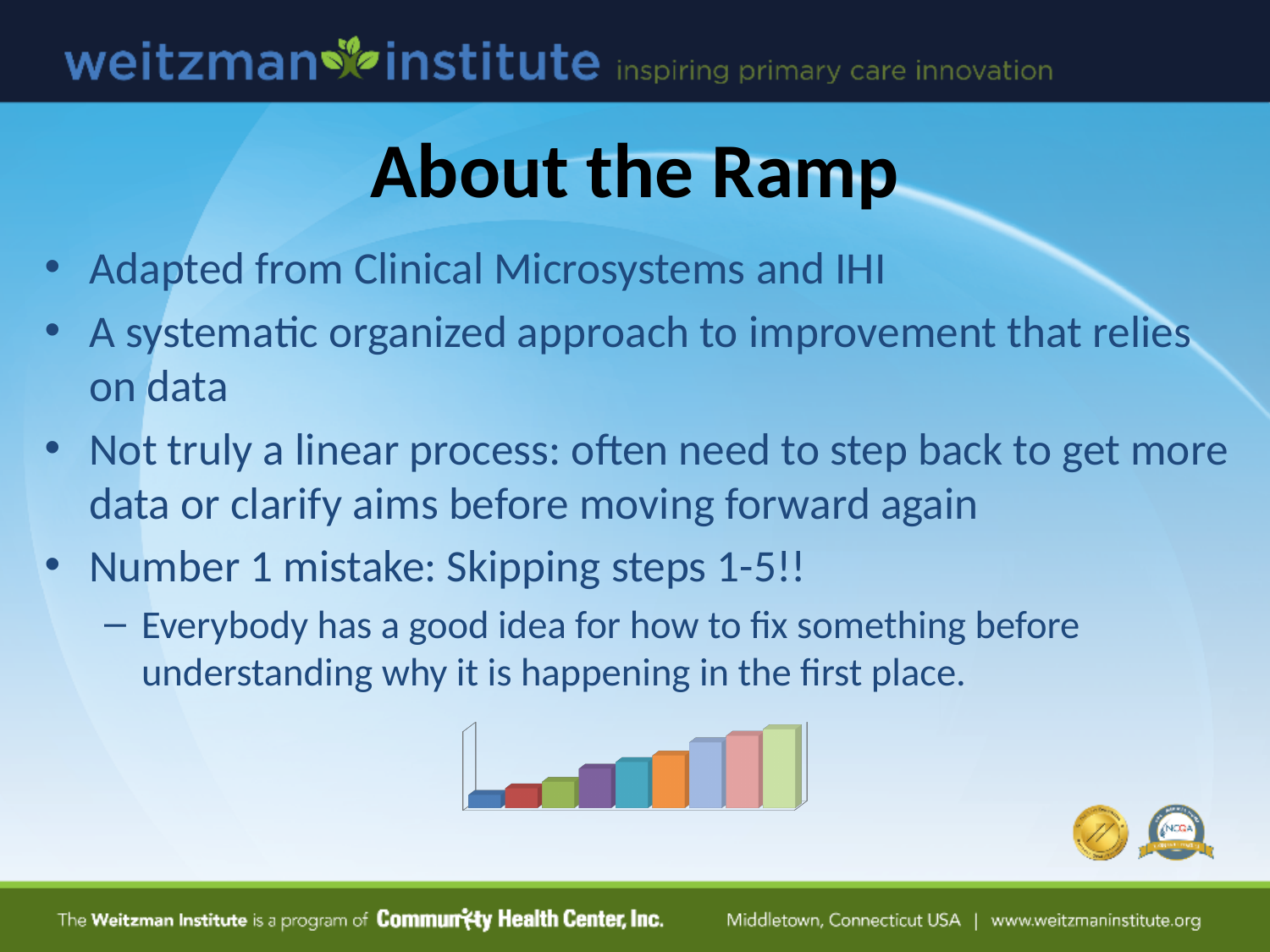
Do the bar heights in the chart rise or fall from left to right? rise What kind of chart is shown at the bottom of the slide? bar chart What colour is the tallest bar in the chart? light green Which bar in the chart is the shortest, the leftmost or the rightmost? leftmost Which bar in the chart is the tallest, the leftmost or the rightmost? rightmost Is the blue bar on the far left taller or shorter than the pink bar? shorter Does the chart display a legend? No How many bars does the chart at the bottom of the slide contain? 9 Is the orange bar taller or shorter than the red bar? taller